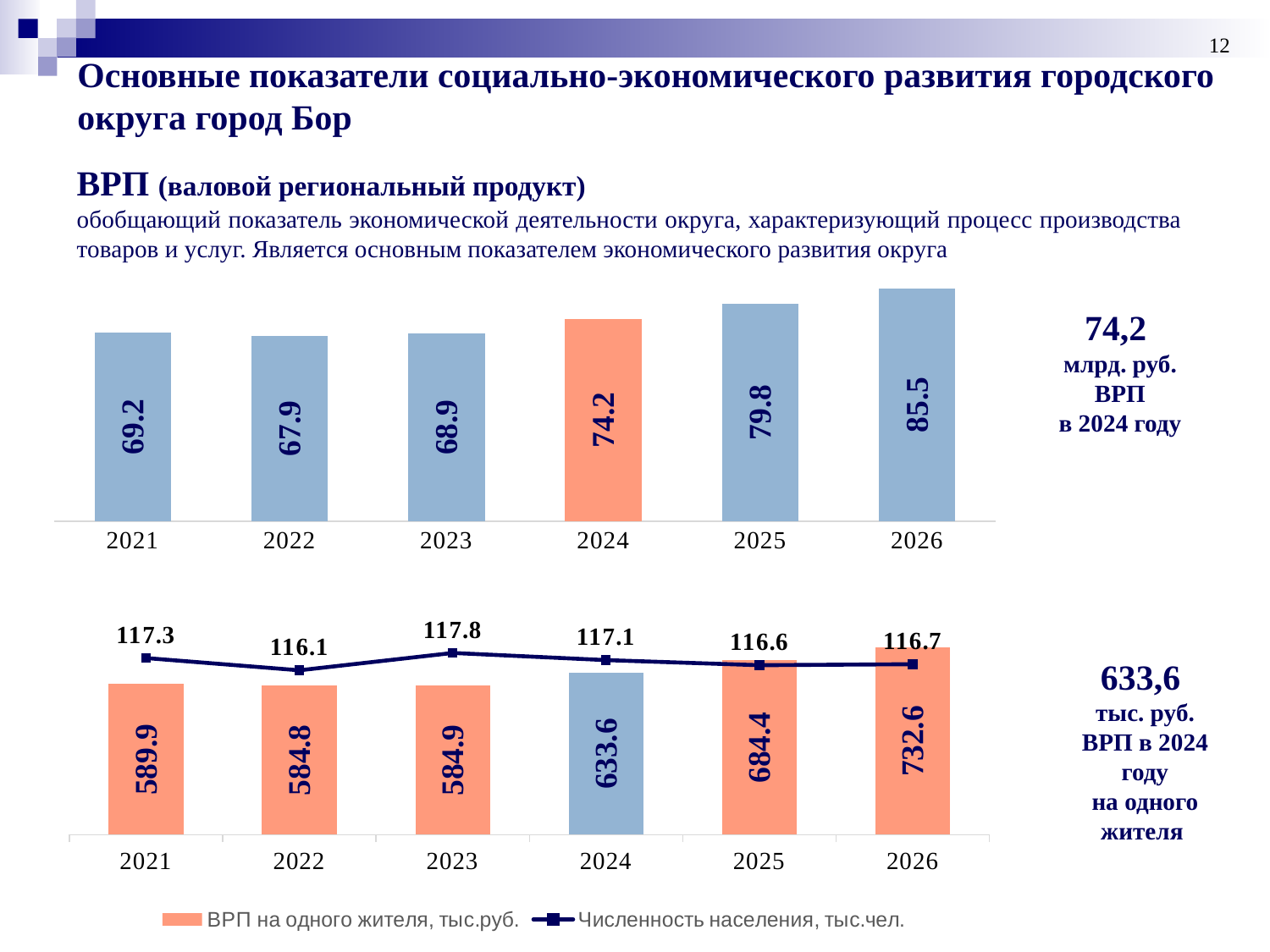
In the top chart, what is the value for 2024? 74.2 In the bottom chart, what is the value of 'Численность населения, тыс.чел.' for 2023? 117.8 In the top chart, which year has the lowest value? 2022 In the top chart, how many years are shown on the x axis? 6 In the bottom chart, what is the value of 'ВРП на одного жителя, тыс.руб.' for 2025? 684.4 In the bottom chart, is the value of 'ВРП на одного жителя, тыс.руб.' larger for 2021 or for 2022? 2021 In the bottom chart, how many series does the legend list? 2 In the top chart, do the values rise or fall from 2023 to 2026? rise In the top chart, which year has the highest value? 2026 In the top chart, what is the difference between the values for 2026 and 2021? 16.3 In the bottom chart, which year has the highest value of 'ВРП на одного жителя, тыс.руб.'? 2026 In the bottom chart, which year has the lowest value of 'Численность населения, тыс.чел.'? 2022